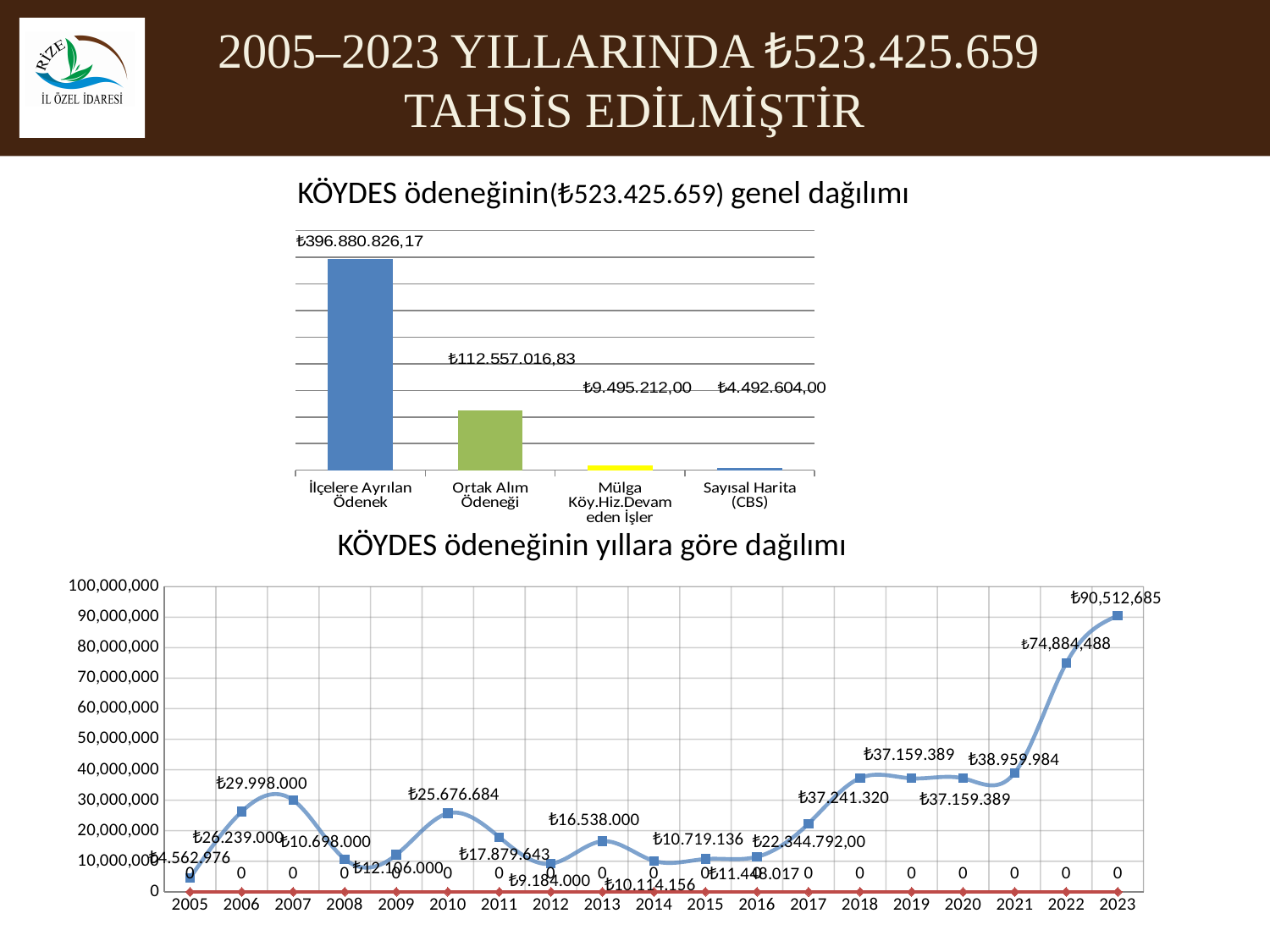
In the 'KÖYDES ödeneğinin(₺523.425.659) genel dağılımı' chart, what is the value for Sayısal Harita (CBS)? ₺4.492.604,00 How many categories are shown in the 'KÖYDES ödeneğinin(₺523.425.659) genel dağılımı' chart? 4 How many years are shown on the x axis of the 'KÖYDES ödeneğinin yıllara göre dağılımı' chart? 19 In the 'KÖYDES ödeneğinin yıllara göre dağılımı' chart, is the value for 2018 greater or less than 30,000,000? greater What kind of chart is the 'KÖYDES ödeneğinin(₺523.425.659) genel dağılımı' chart? bar chart In the 'KÖYDES ödeneğinin yıllara göre dağılımı' chart, which year has the highest value? 2023 In the 'KÖYDES ödeneğinin yıllara göre dağılımı' chart, what is the value for 2007? ₺29.998.000 In the 'KÖYDES ödeneğinin(₺523.425.659) genel dağılımı' chart, what is the value for İlçelere Ayrılan Ödenek? ₺396.880.826,17 In the 'KÖYDES ödeneğinin(₺523.425.659) genel dağılımı' chart, which category has the lowest value? Sayısal Harita (CBS) In the 'KÖYDES ödeneğinin(₺523.425.659) genel dağılımı' chart, which category has the highest value? İlçelere Ayrılan Ödenek In the 'KÖYDES ödeneğinin yıllara göre dağılımı' chart, what is the value for 2023? ₺90,512,685 In the 'KÖYDES ödeneğinin yıllara göre dağılımı' chart, which year has the larger value, 2021 or 2022? 2022